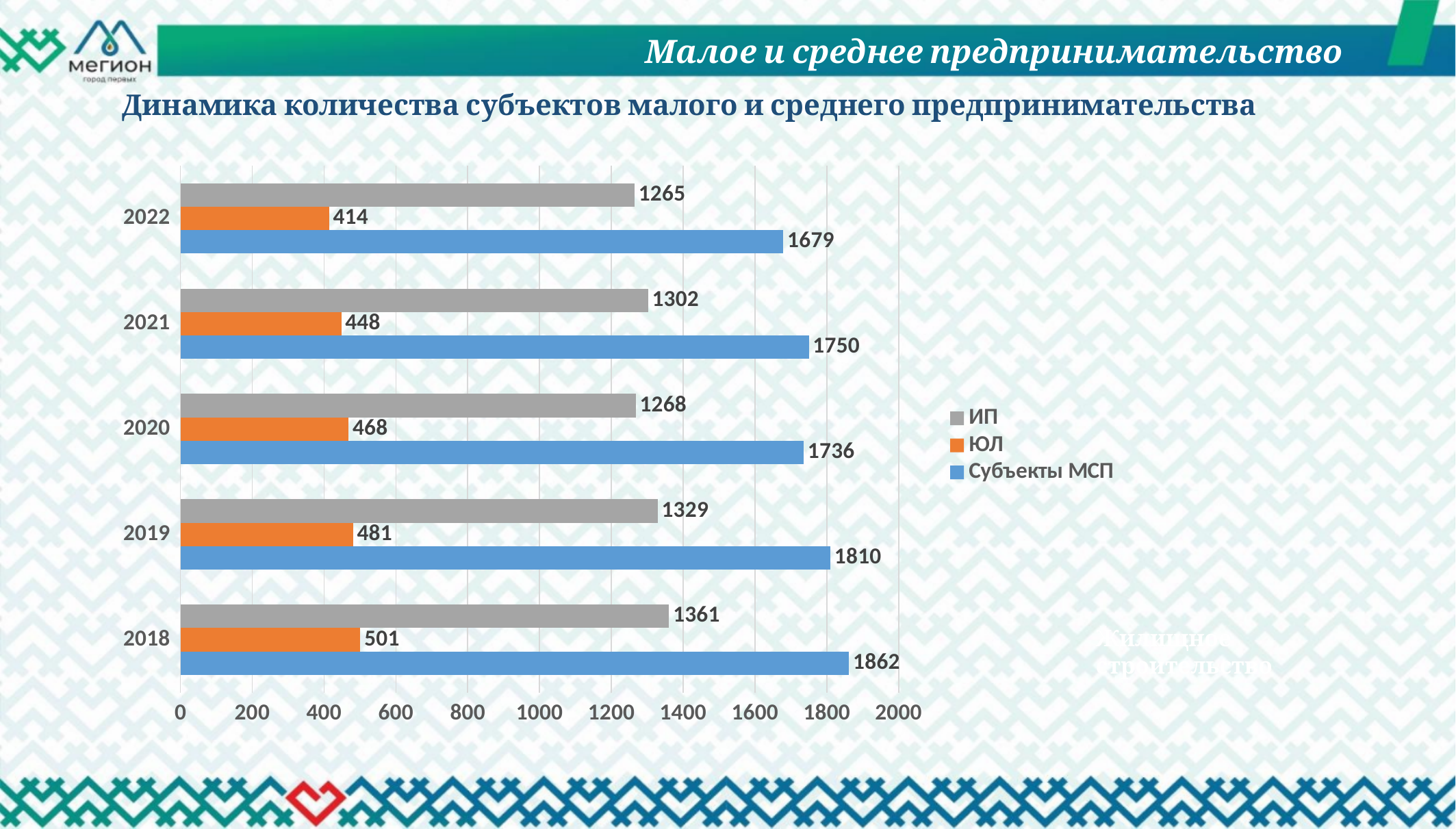
What is the value for ЮЛ in 2019? 481 Does the value for ЮЛ rise or fall from 2018 to 2022? Fall What colour are the bars for Субъекты МСП? Blue In which year is the value for Субъекты МСП highest? 2018 What is the value for Субъекты МСП in 2022? 1679 How many years are shown on the chart? 5 What kind of chart is shown on the slide? Bar chart How many series does the legend list? 3 Which is larger: the ИП value for 2021 or the ИП value for 2022? 2021 In which year is the value for ЮЛ lowest? 2022 What is the value for ИП in 2020? 1268 What is the difference between the Субъекты МСП values for 2018 and 2022? 183